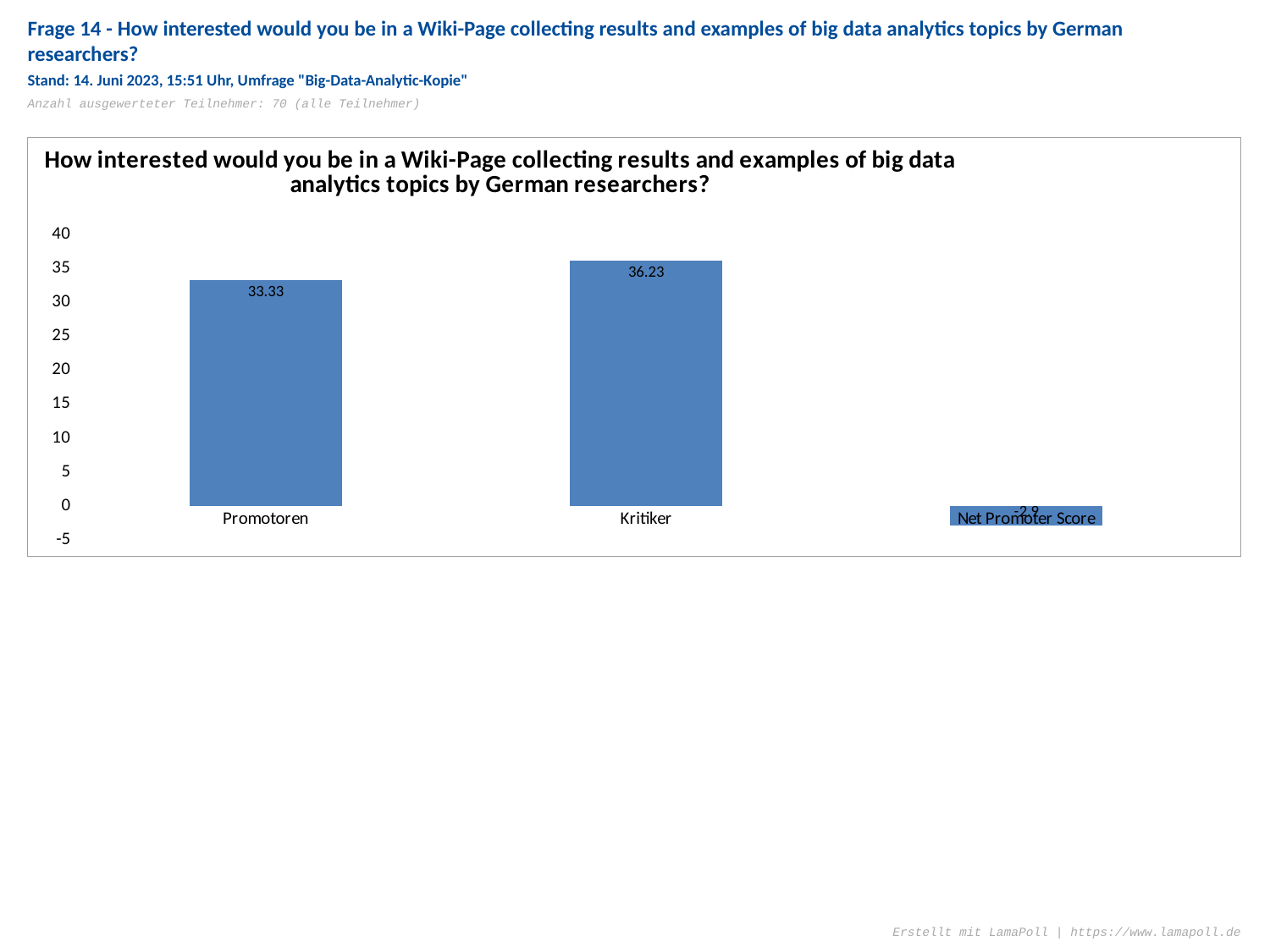
Which category has the lowest value? Net Promoter Score What kind of chart is shown on the slide? bar chart What is the value for Promotoren? 33.33 What is the lowest value shown on the y axis? -5 Is the value for Net Promoter Score greater or less than 0? less Is the value for Kritiker greater or less than 40? less Is the value for Promotoren greater or less than 30? greater Which is larger, the value for Promotoren or the value for Kritiker? Kritiker What is the value for Kritiker? 36.23 Which category has the highest value? Kritiker What is the difference between the values for Kritiker and Promotoren? 2.9 How many categories are shown on the x axis? 3